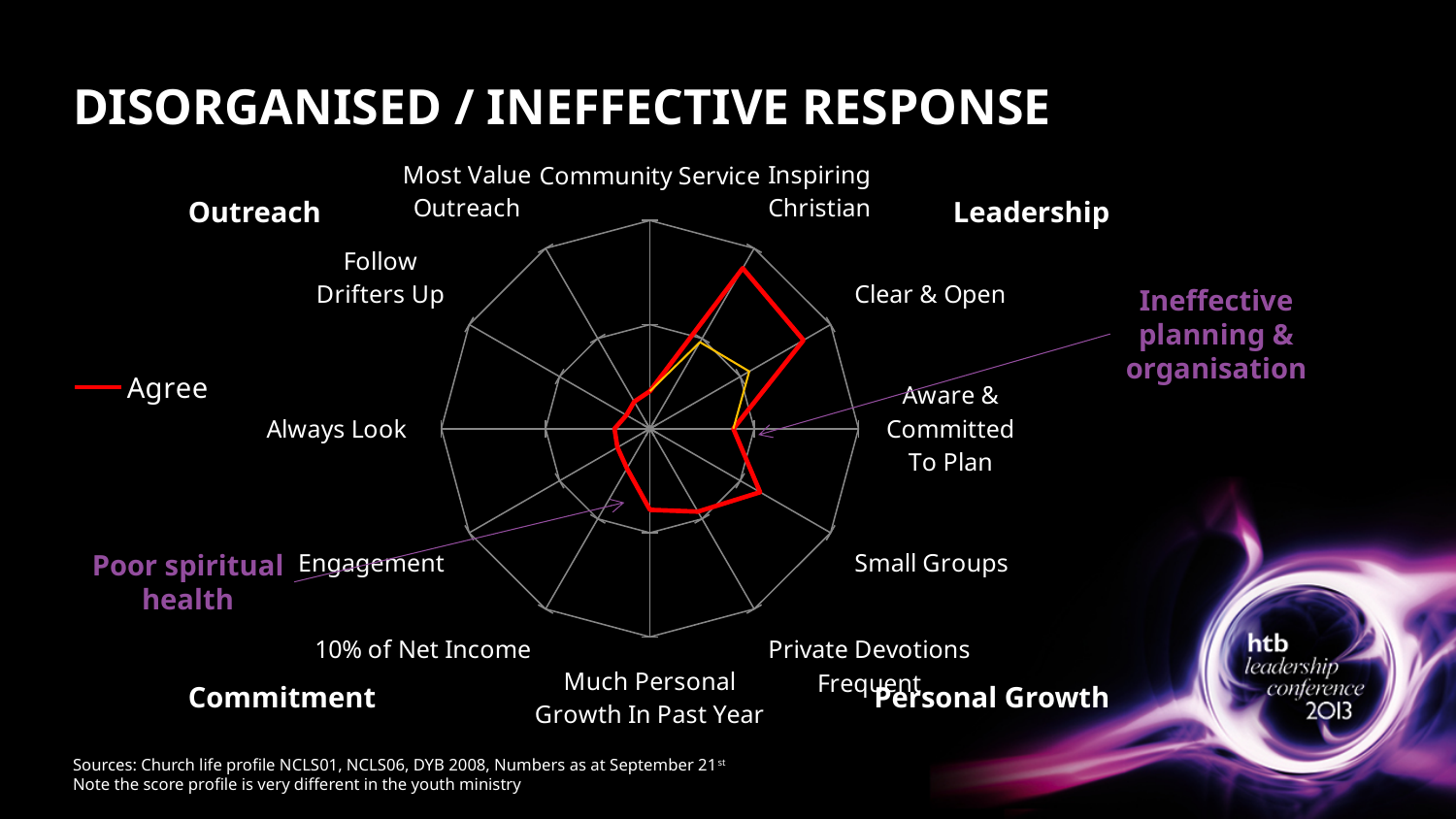
Which has the larger 'Agree' value, Inspiring Christian or Engagement? Inspiring Christian What kind of chart is shown on the slide? Radar chart Which has the larger 'Agree' value, Clear & Open or Aware & Committed To Plan? Clear & Open Which has the larger 'Agree' value, Clear & Open or Always Look? Clear & Open What is the name of the series shown in the chart's legend? Agree How many series does the chart's legend list? 1 What colour is the 'Agree' line in the chart? Red